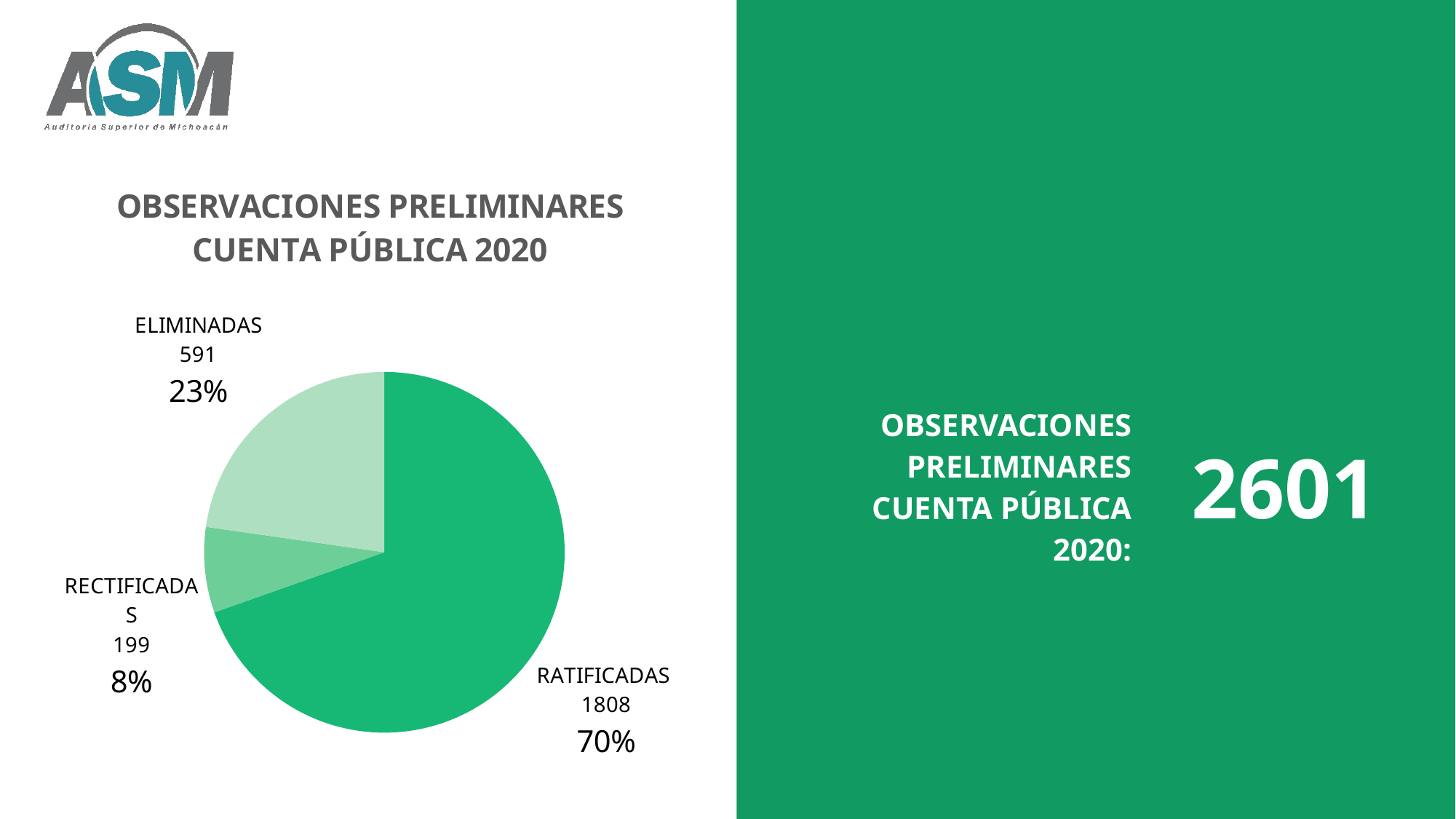
Which category has the smallest slice? RECTIFICADAS What is the value for ELIMINADAS? 591 Which category has the largest slice? RATIFICADAS What share of the pie does RATIFICADAS represent? 70% What share of the pie does ELIMINADAS represent? 23% What share of the pie does RECTIFICADAS represent? 8% How many slices does the pie chart have? 3 What kind of chart is shown on the slide? pie chart What is the value for RATIFICADAS? 1808 What is the difference between the values for RATIFICADAS and ELIMINADAS? 1217 What is the title of the chart? OBSERVACIONES PRELIMINARES CUENTA PÚBLICA 2020 What is the value for RECTIFICADAS? 199